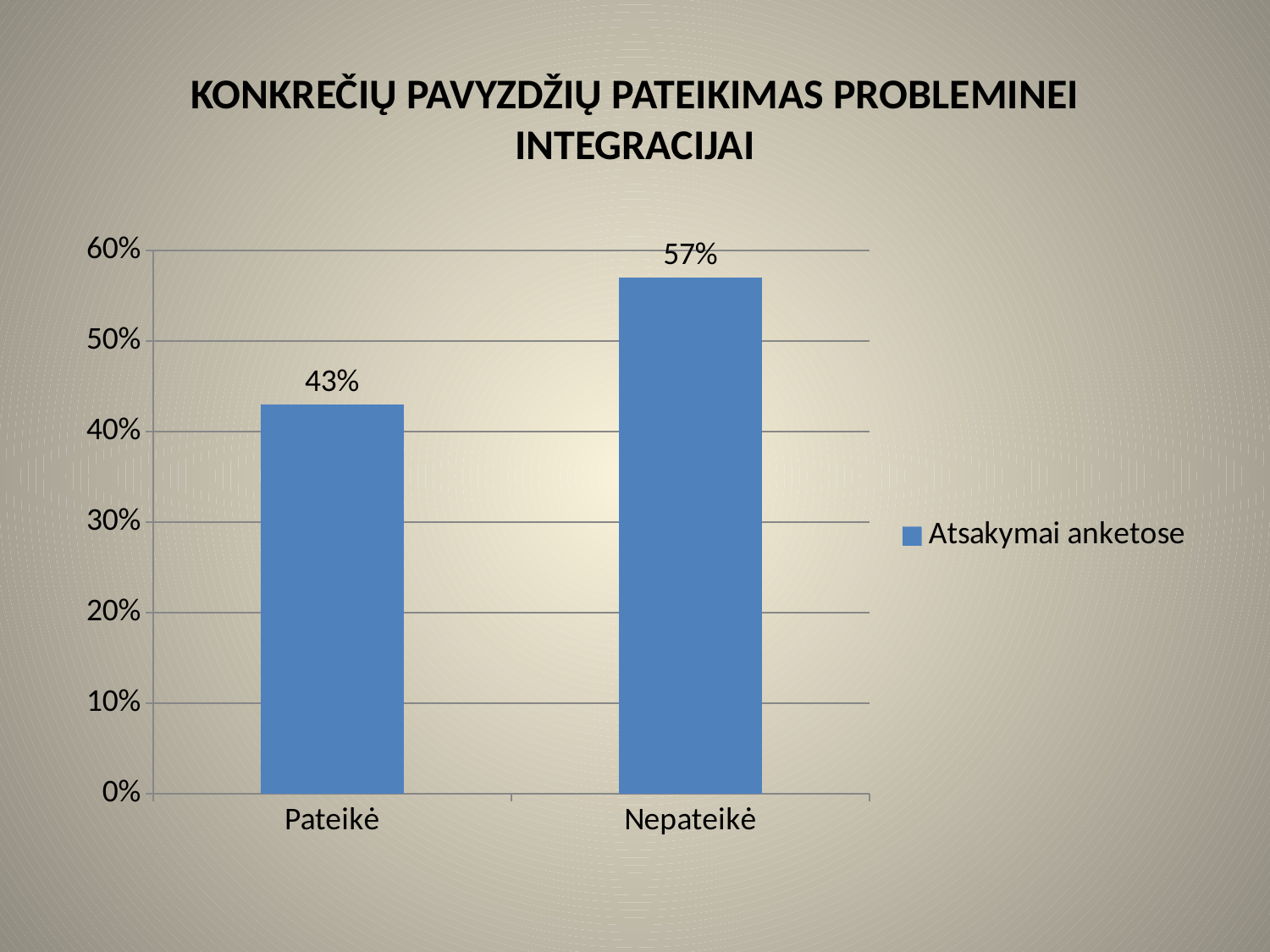
What is the difference between the values for Nepateikė and Pateikė? 14% How many categories are shown on the x axis? 2 Is the value for Nepateikė greater or less than 50%? greater What kind of chart is shown on the slide? bar chart Which is larger, the value for Pateikė or the value for Nepateikė? Nepateikė Which category has the highest value? Nepateikė How many series does the legend list? 1 What is the value for Pateikė? 43% What is the name of the series shown in the legend? Atsakymai anketose What is the value for Nepateikė? 57% Is the value for Pateikė greater or less than 50%? less Which category has the lowest value? Pateikė